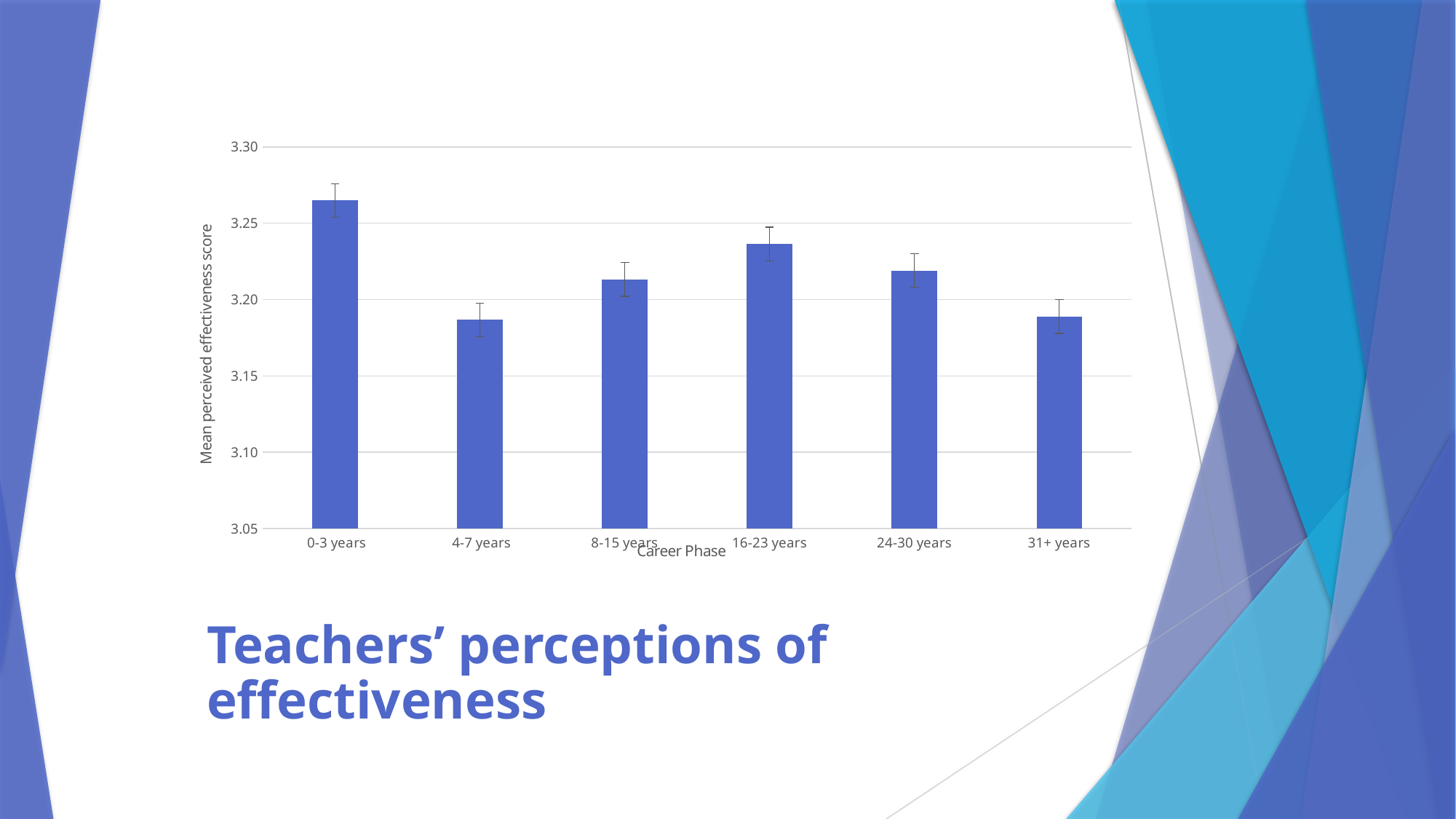
Is the value for 4-7 years greater or less than 3.20? less Is the value for 24-30 years greater or less than 3.20? greater How many career phase categories are shown on the x axis? 6 What is the label of the horizontal axis? Career Phase Which career phase has the highest mean perceived effectiveness score? 0-3 years Is the value for 16-23 years greater or less than 3.20? greater What type of chart is shown on the slide? bar chart Which has a higher mean perceived effectiveness score, 16-23 years or 8-15 years? 16-23 years Which has a higher mean perceived effectiveness score, 0-3 years or 4-7 years? 0-3 years What is the label of the vertical axis? Mean perceived effectiveness score